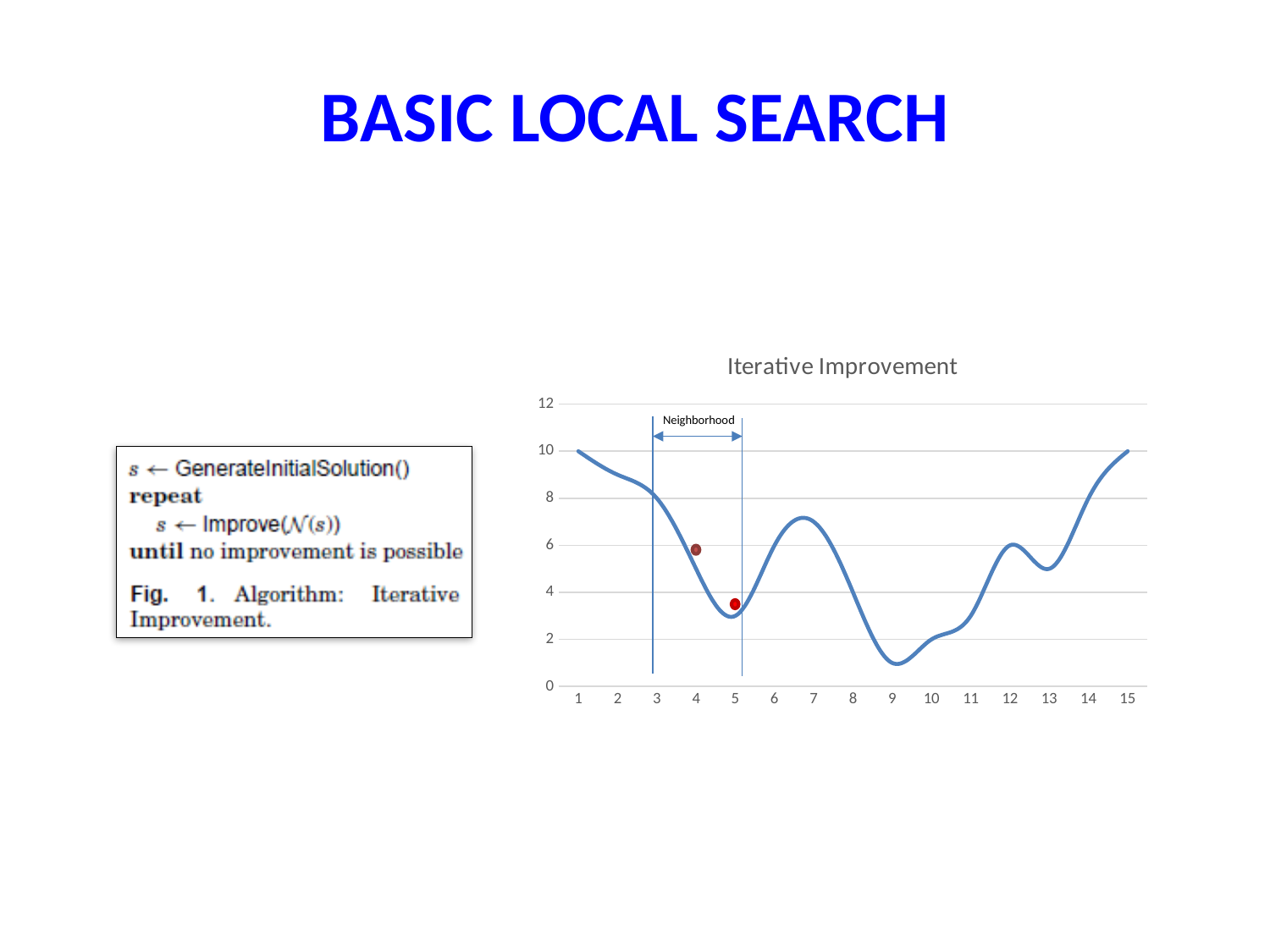
Is the value of the line at x = 7 greater or less than 6? greater Which has the larger value on the line, x = 7 or x = 9? x = 7 What is the title of the chart? Iterative Improvement Is the value of the line at x = 2 greater or less than 8? greater What kind of chart is shown on the slide? line chart What is the highest value shown on the y axis of the chart? 12 Does the line rise or fall between x = 1 and x = 5? fall How many points are labelled along the x axis of the chart? 15 At which x value does the line reach its lowest point? 9 Is the value of the line at x = 12 greater or less than 4? greater